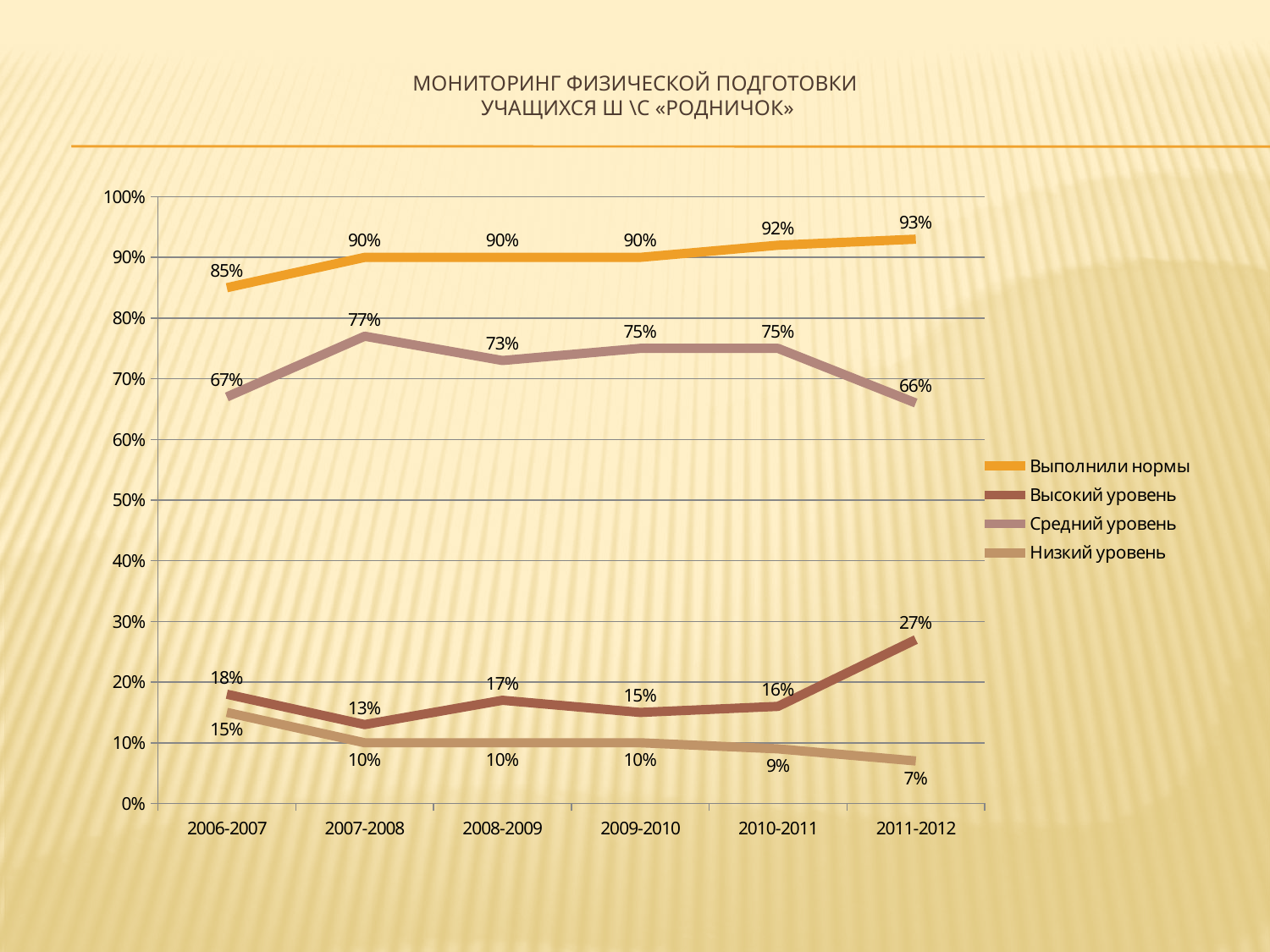
What is the value of Низкий уровень for 2010-2011? 9% Does Низкий уровень rise or fall from 2006-2007 to 2011-2012? fall In which school year is Высокий уровень highest? 2011-2012 What is the value of Выполнили нормы for 2011-2012? 93% What type of chart is shown on the slide? line chart Which series is drawn in orange? Выполнили нормы What is the difference between Средний уровень in 2007-2008 and in 2011-2012? 11% Which is larger in 2006-2007: Высокий уровень or Низкий уровень? Высокий уровень What is the value of Средний уровень for 2007-2008? 77% In which school year is Выполнили нормы lowest? 2006-2007 How many school years are shown on the x axis? 6 How many series does the legend list? 4